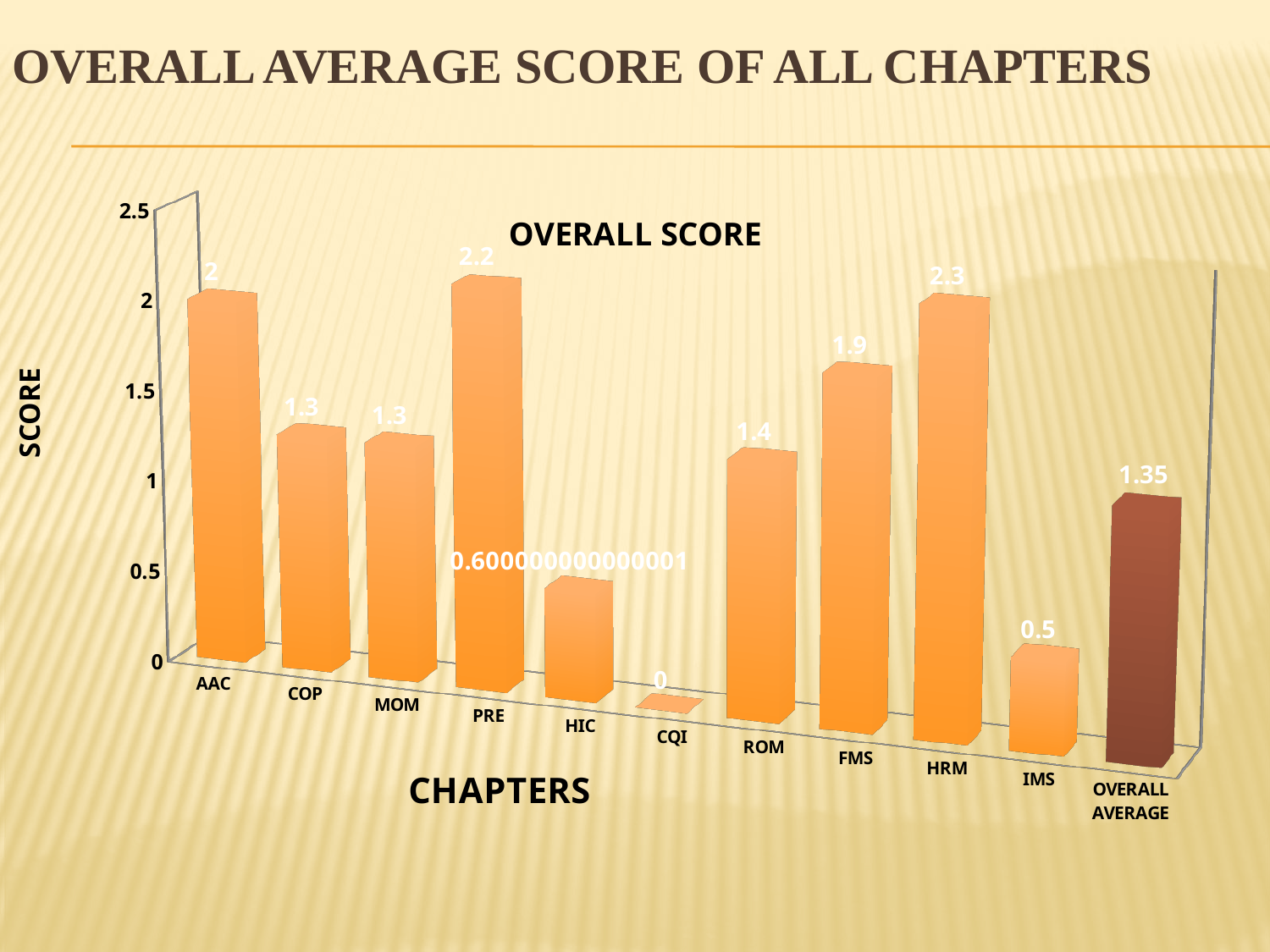
How many categories are shown on the x axis? 11 What is the title of the chart? OVERALL SCORE Is the value for HIC greater or less than 1? less Which is larger, the value for FMS or the value for ROM? FMS What is the value for AAC? 2 Which chapter has the lowest score? CQI What is the value for PRE? 2.2 Which chapter has the highest score? HRM What is the value for IMS? 0.5 What is the value for OVERALL AVERAGE? 1.35 What is the difference between the values for HRM and IMS? 1.8 What kind of chart is shown on the slide? bar chart